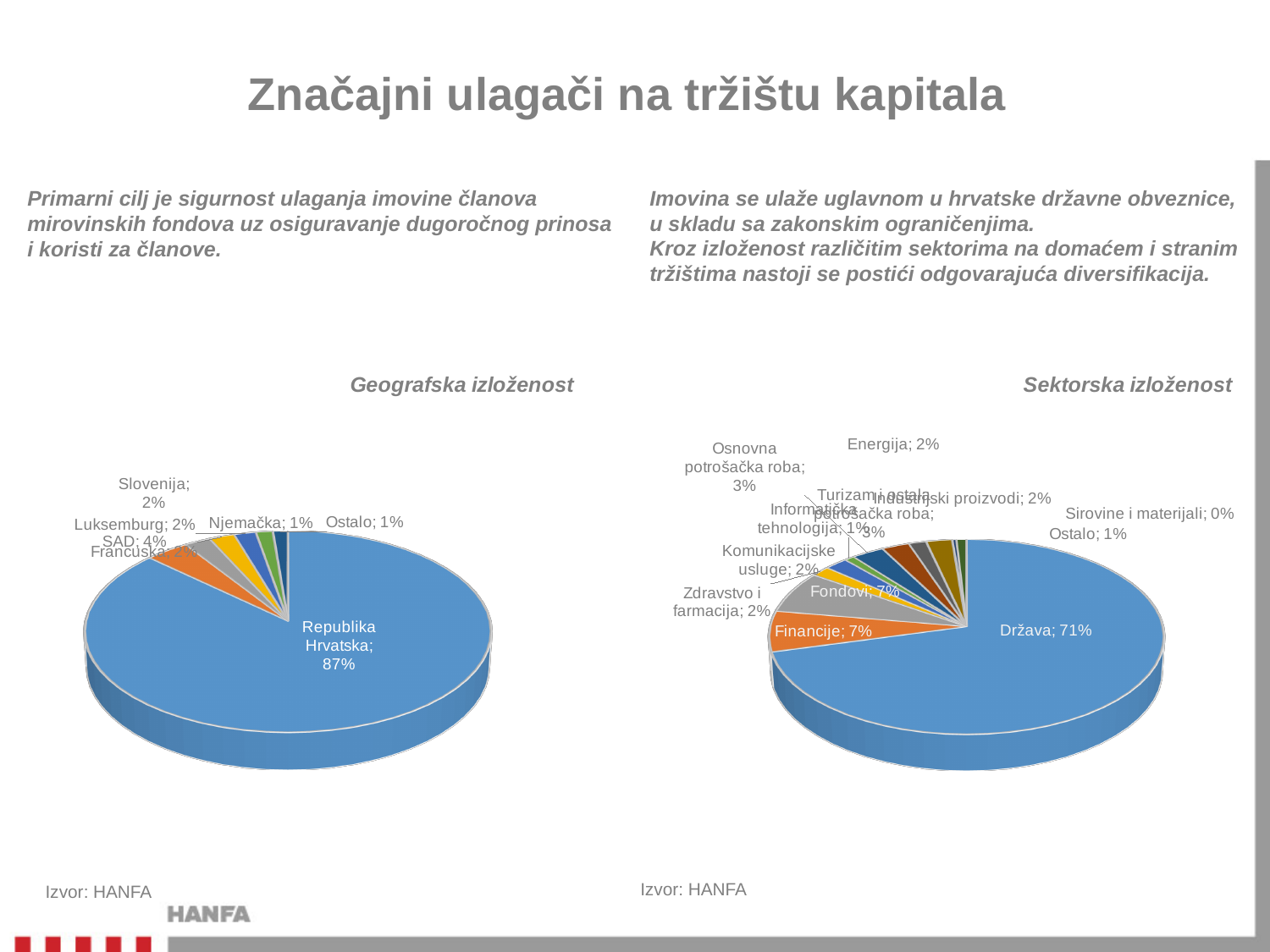
On the Sektorska izloženost chart, what share does Osnovna potrošačka roba have? 3% On the Sektorska izloženost chart, which sector has the smallest share? Sirovine i materijali How many slices does the Geografska izloženost chart have? 7 On the Geografska izloženost chart, what share does Republika Hrvatska have? 87% On the Geografska izloženost chart, what share does SAD have? 4% On the Sektorska izloženost chart, what share does Energija have? 2% On the Sektorska izloženost chart, what share does Financije have? 7% On the Geografska izloženost chart, how many percentage points larger is Republika Hrvatska than SAD? 83 percentage points On the Sektorska izloženost chart, which sector has the largest share? Država On the Geografska izloženost chart, which category has the largest share? Republika Hrvatska On the Sektorska izloženost chart, what share does Država have? 71% What type of chart is the Geografska izloženost chart? Pie chart